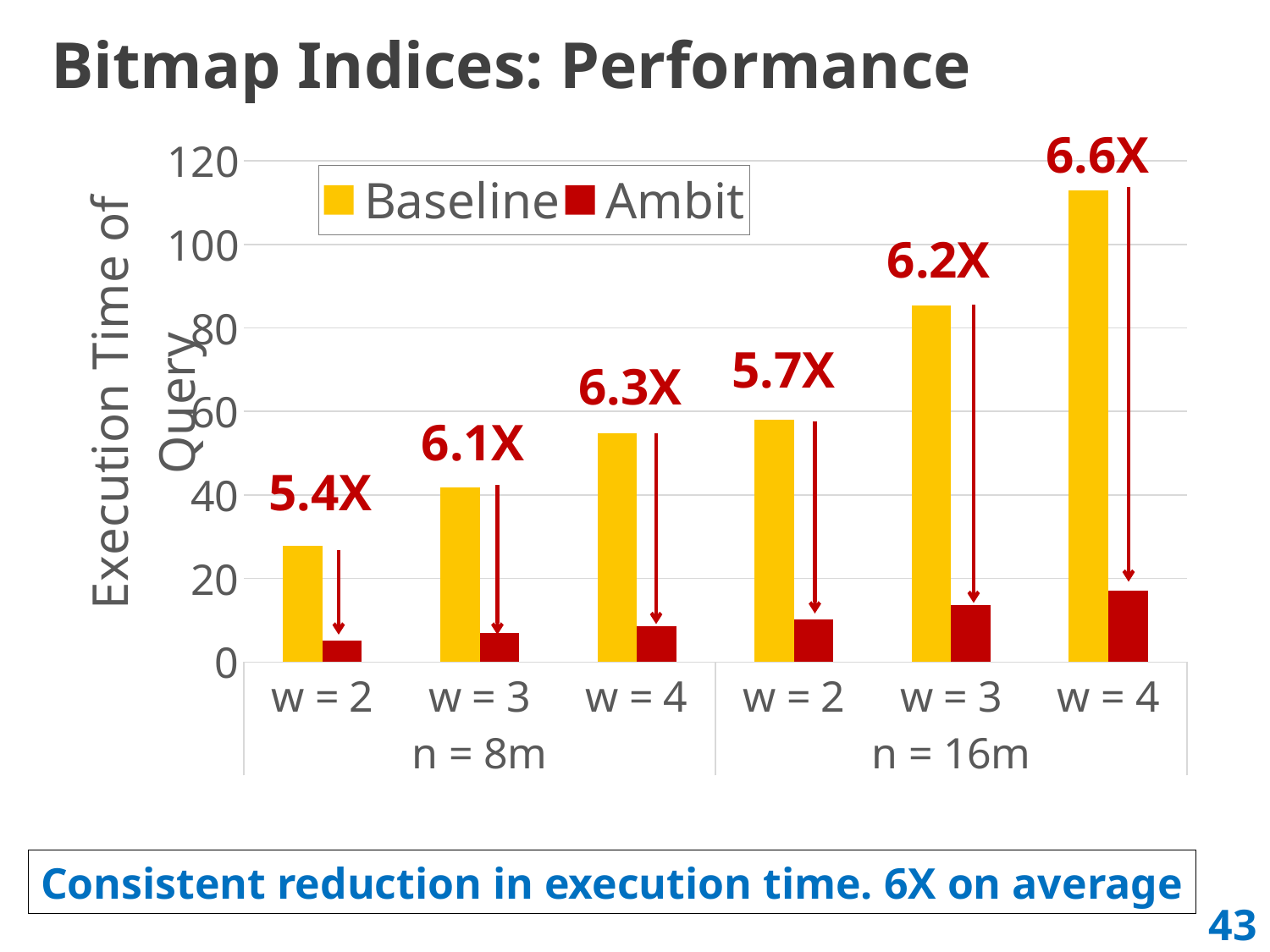
Which category has the lowest Baseline execution time? w = 2, n = 8m Which category has the highest Baseline execution time? w = 4, n = 16m How many category groups (w values) are plotted along the x axis? 6 Within the n = 8m group, do the Baseline values rise or fall as w increases from 2 to 4? rise What are the two series named in the legend? Baseline and Ambit Is the Baseline value for w = 4, n = 16m greater or less than 100? greater What speedup is annotated above the bars for w = 4, n = 16m? 6.6X Is the Baseline value for w = 3, n = 16m greater or less than 80? greater Is the Ambit value for w = 2, n = 8m greater or less than 20? less Which is larger: the Baseline value for w = 3, n = 16m or the Baseline value for w = 4, n = 8m? w = 3, n = 16m What kind of chart is shown on the slide? bar chart How many series does the legend list? 2